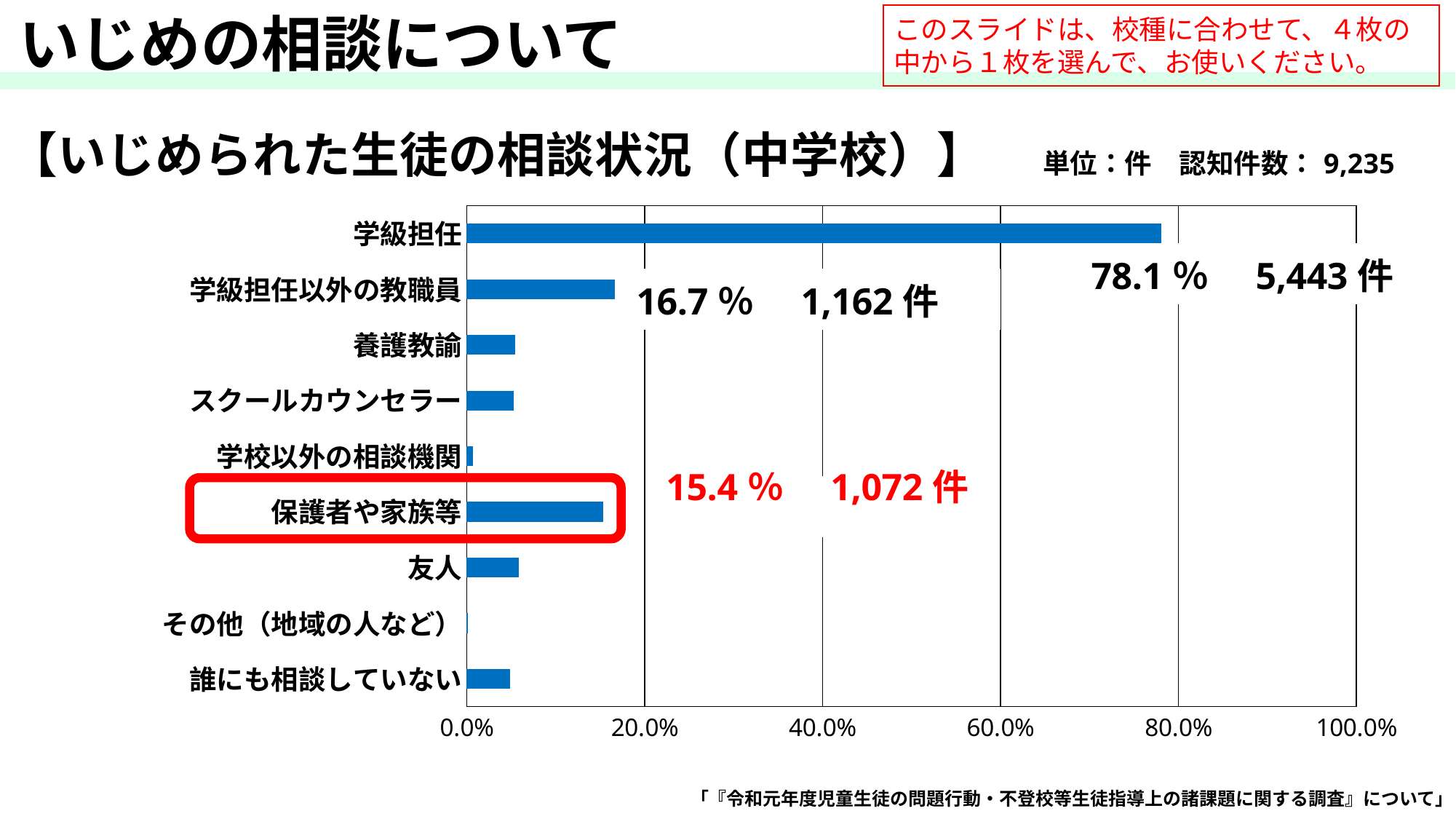
What is the difference in cases between 学級担任以外の教職員 (1,162件) and 保護者や家族等 (1,072件)? 90件 How many categories are shown on the chart? 9 Which category has the highest value? 学級担任 What percentage is shown for 学級担任以外の教職員? 16.7％ How many cases (件) are shown for 保護者や家族等? 1,072件 What kind of chart is shown on the slide? bar chart How many cases (件) are shown for 学級担任? 5,443件 Is the value for 学級担任 greater or less than 60.0%? greater Is the value for 友人 greater or less than 20.0%? less What is the difference in percentage points between 学級担任以外の教職員 (16.7％) and 保護者や家族等 (15.4％)? 1.3 What percentage is shown for 学級担任? 78.1％ Which is larger, the value for 学級担任以外の教職員 or for 保護者や家族等? 学級担任以外の教職員